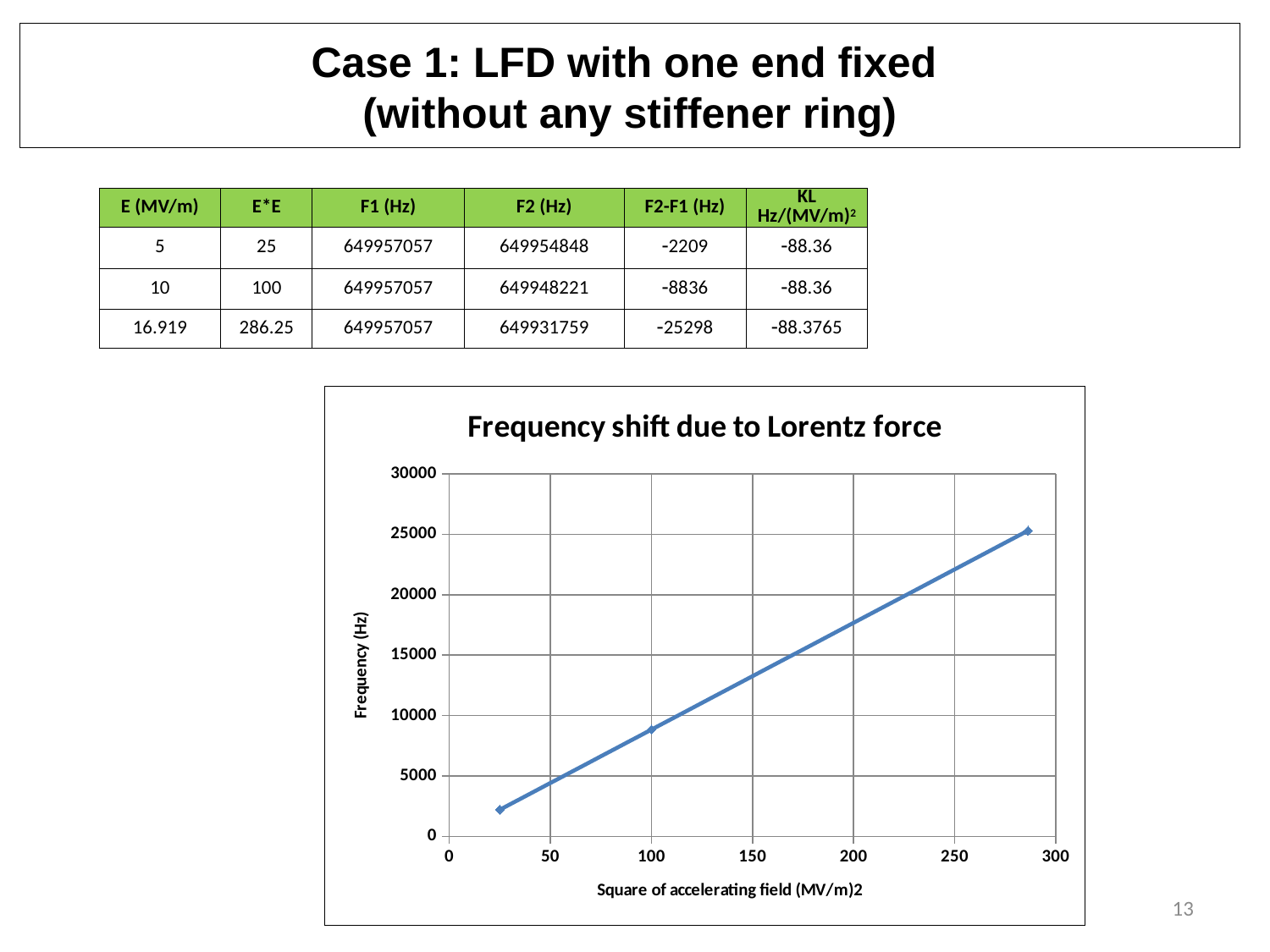
Which has the larger frequency value: the point at a square of accelerating field of 100 or the point near 25? the point at 100 Is the frequency value at a square of accelerating field of 100 greater or less than 10000? less How many data points are plotted on the chart? 3 What is the label of the y axis of the chart? Frequency (Hz) Does the frequency shift rise or fall as the square of the accelerating field increases? rise What is the highest value shown on the y axis of the chart? 30000 Is the frequency value of the leftmost point (near 25 on the x axis) greater or less than 5000? less Is the frequency value of the rightmost point greater or less than 20000? greater What type of chart is shown on the slide? line chart What is the title of the chart? Frequency shift due to Lorentz force